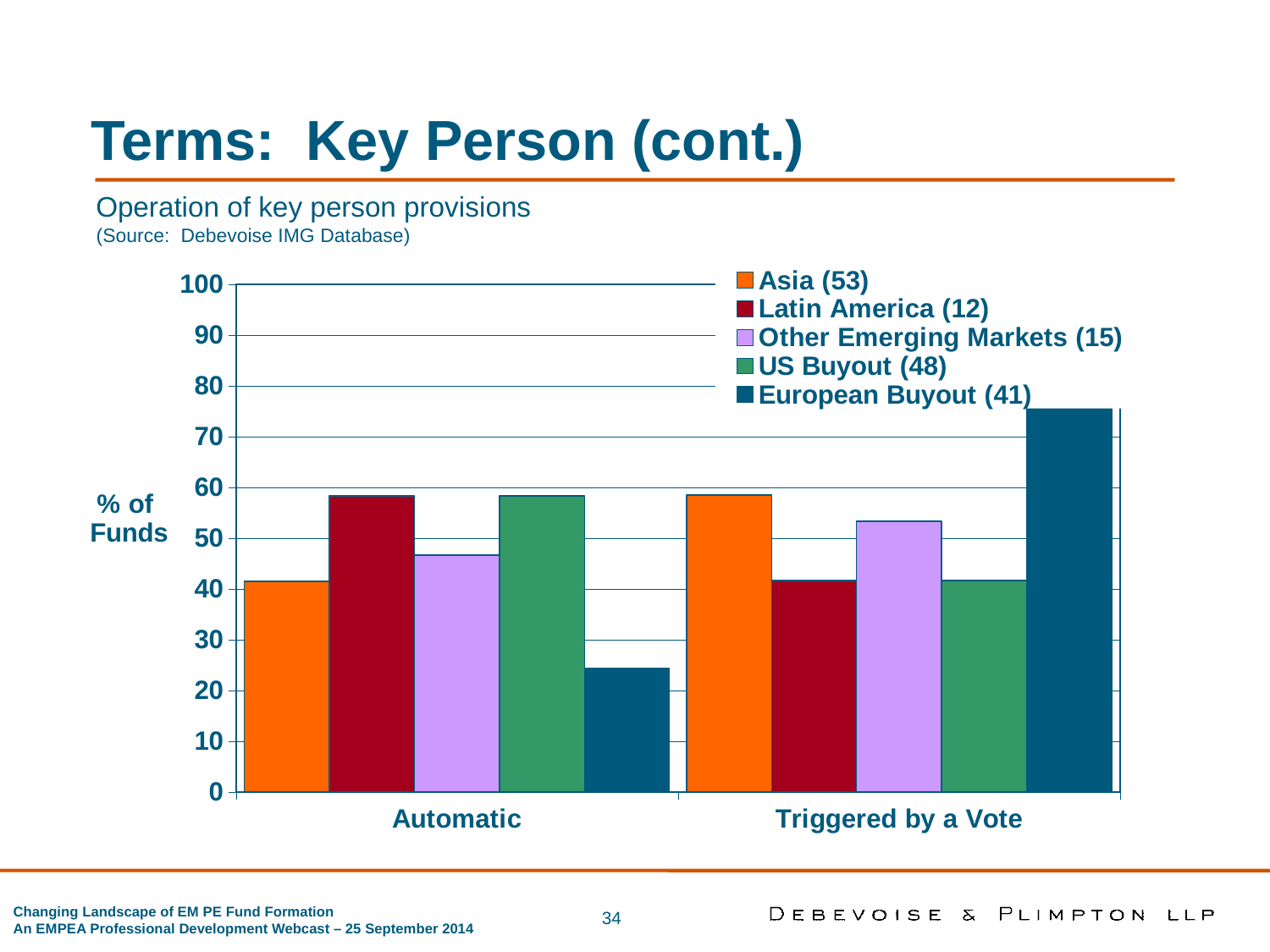
What kind of chart is shown on the slide? bar chart How many categories are shown on the x axis? 2 For Latin America (12), which category has the larger value: Automatic or Triggered by a Vote? Automatic How many series does the legend list? 5 Is the value for Latin America (12) in the Automatic category greater or less than 50? greater What is the label on the y axis of the chart? % of Funds Is the value for European Buyout (41) in the Automatic category greater or less than 30? less Which series has the lowest value in the Automatic category? European Buyout (41) Which series has the highest value in the Triggered by a Vote category? European Buyout (41) For European Buyout (41), which category has the larger value: Automatic or Triggered by a Vote? Triggered by a Vote Is the value for US Buyout (48) in the Triggered by a Vote category greater or less than 50? less